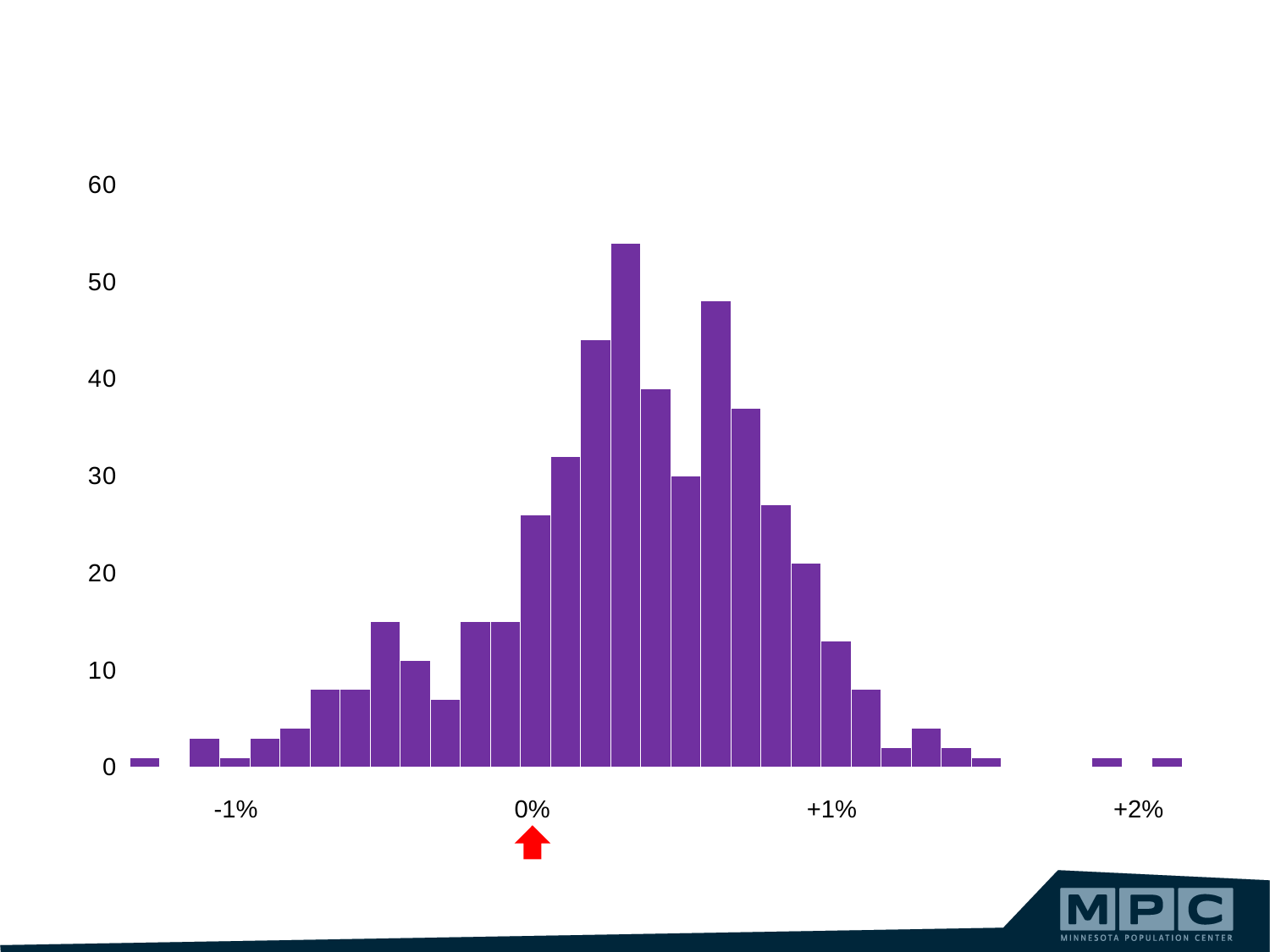
Is the value of the tallest bar greater or less than 50? greater What is the highest value labelled on the y axis? 60 What kind of chart is shown on the slide? bar chart Is the value of the tallest bar greater or less than 60? less Is the value of the second tallest bar greater or less than 40? greater Which x-axis tick label does the red arrow point to? 0% Is the tallest bar located between 0% and +1% on the x axis, or between -1% and 0%? between 0% and +1% Do the bar heights generally rise or fall moving from the peak toward +2%? fall Do the bar heights generally rise or fall moving from -1% toward the peak just right of 0%? rise